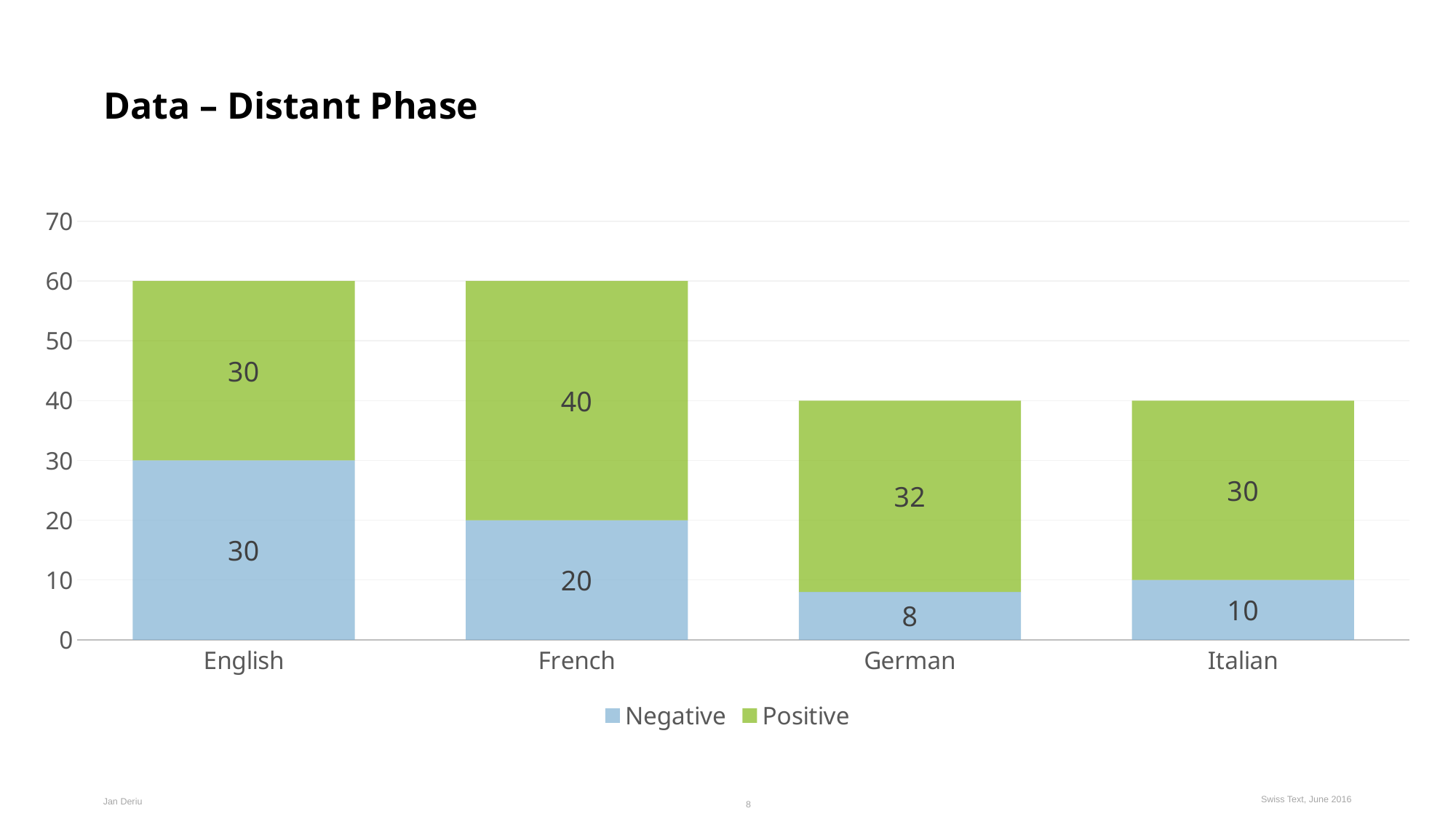
What type of chart is shown on the slide? Stacked bar chart What is the total of the stacked bar for English? 60 What is the Negative value for Italian? 10 Which language has the lowest Negative value? German What is the total of the stacked bar for Italian? 40 What is the Negative value for German? 8 Which is larger: the Negative value for English or the Negative value for French? English How many series does the legend list? 2 Which language has the highest Positive value? French What is the difference between the Positive and Negative values for German? 24 What is the Positive value for French? 40 How many languages are shown on the x axis? 4